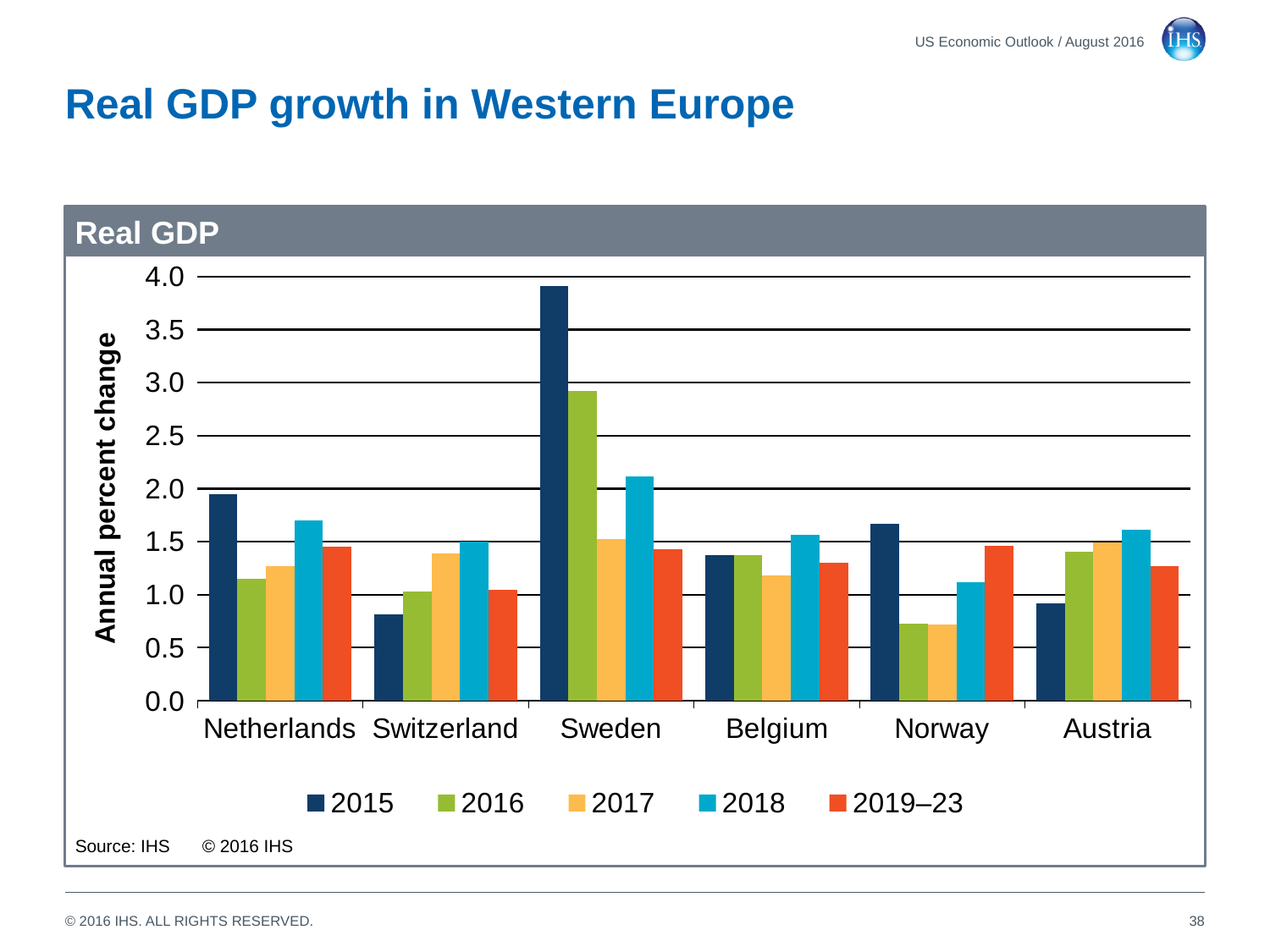
Which country has the highest 2015 real GDP growth? Sweden Which country has the lowest 2015 real GDP growth? Switzerland Is the 2015 value for Switzerland greater or less than 1.0? less Is the 2016 value for Sweden greater or less than 2.5? greater How many countries are shown on the x axis of the Real GDP chart? 6 Is the 2015 value for Sweden greater or less than 3.5? greater What is the label on the y axis of the Real GDP chart? Annual percent change Which country has the lowest 2016 real GDP growth? Norway Which country has the highest 2018 real GDP growth? Sweden For the Netherlands, which is larger: the 2015 value or the 2016 value? 2015 How many series does the legend of the Real GDP chart list? 5 What kind of chart is shown on the slide? bar chart